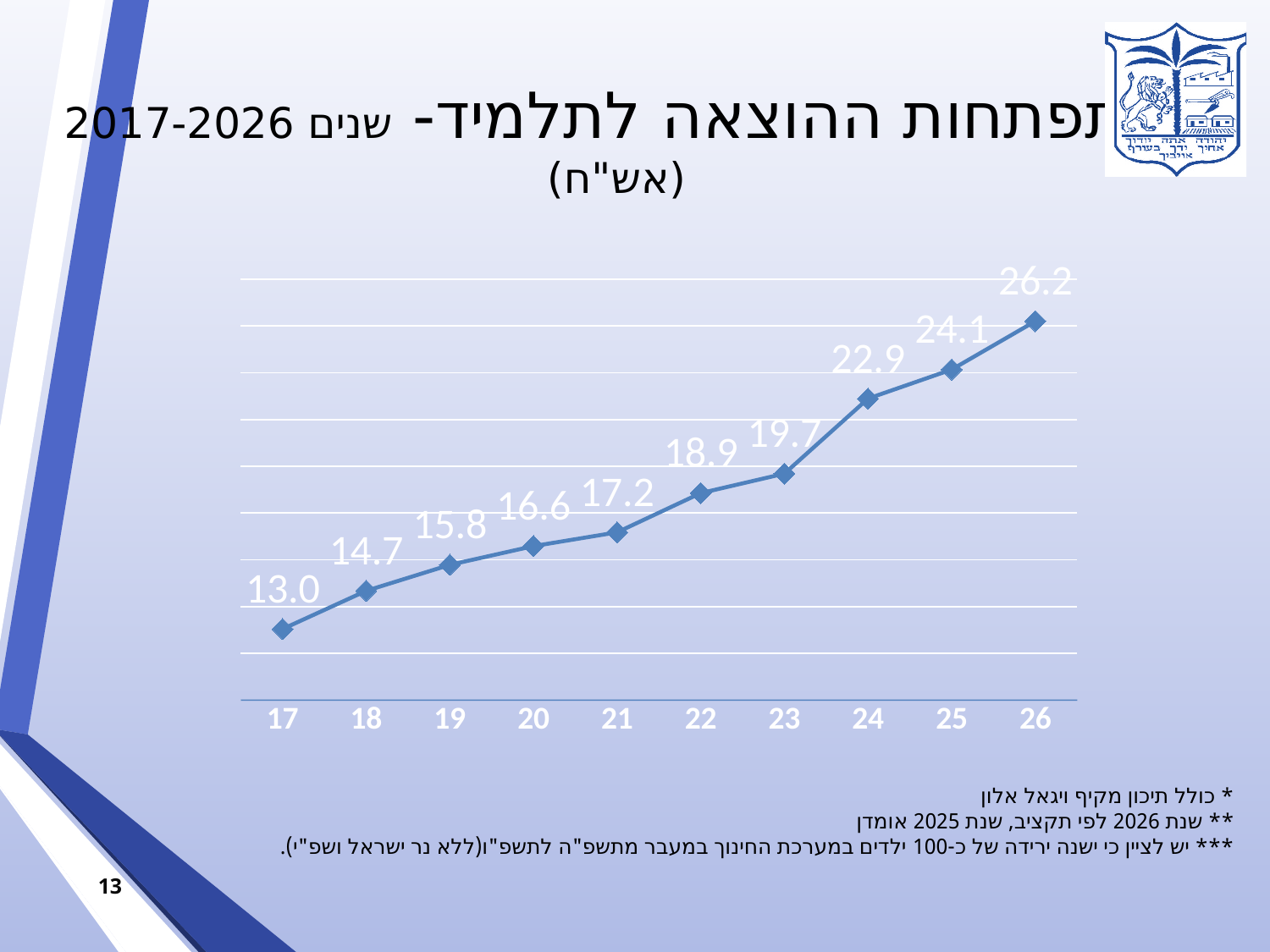
What type of chart is shown on the slide? line chart What is the difference between the values for year 26 and year 17? 13.2 What is the difference between the values for year 24 and year 23? 3.2 What is the value for year 24? 22.9 What is the value for year 22? 18.9 How many years are plotted on the x axis? 10 Which is larger, the value for year 20 or the value for year 25? 25 Do the values rise or fall from year 17 to year 26? rise What is the value for year 26? 26.2 Which year has the highest value? 26 Which year has the lowest value? 17 What is the value for year 17? 13.0